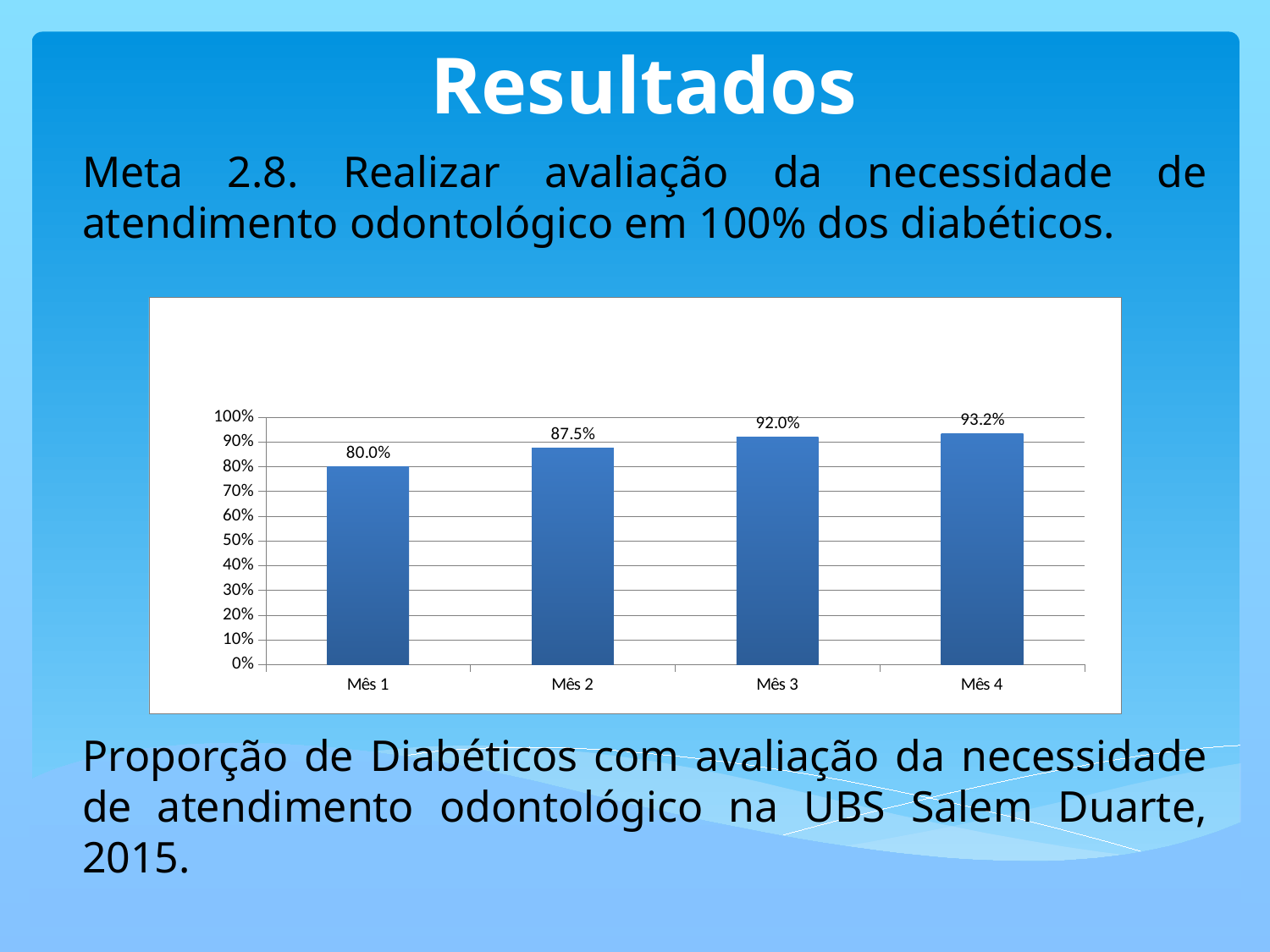
Which is larger, the value for Mês 2 or the value for Mês 3? Mês 3 What is the value for Mês 4? 93.2% What is the maximum value shown on the y axis? 100% Do the values rise or fall from Mês 1 to Mês 4? rise Is the value for Mês 1 greater or less than 90%? less Which month has the highest value? Mês 4 How many months are shown on the x axis? 4 What is the value for Mês 1? 80.0% What is the value for Mês 3? 92.0% What kind of chart is shown on the slide? bar chart What is the difference between the values for Mês 2 and Mês 1? 7.5% Which month has the lowest value? Mês 1